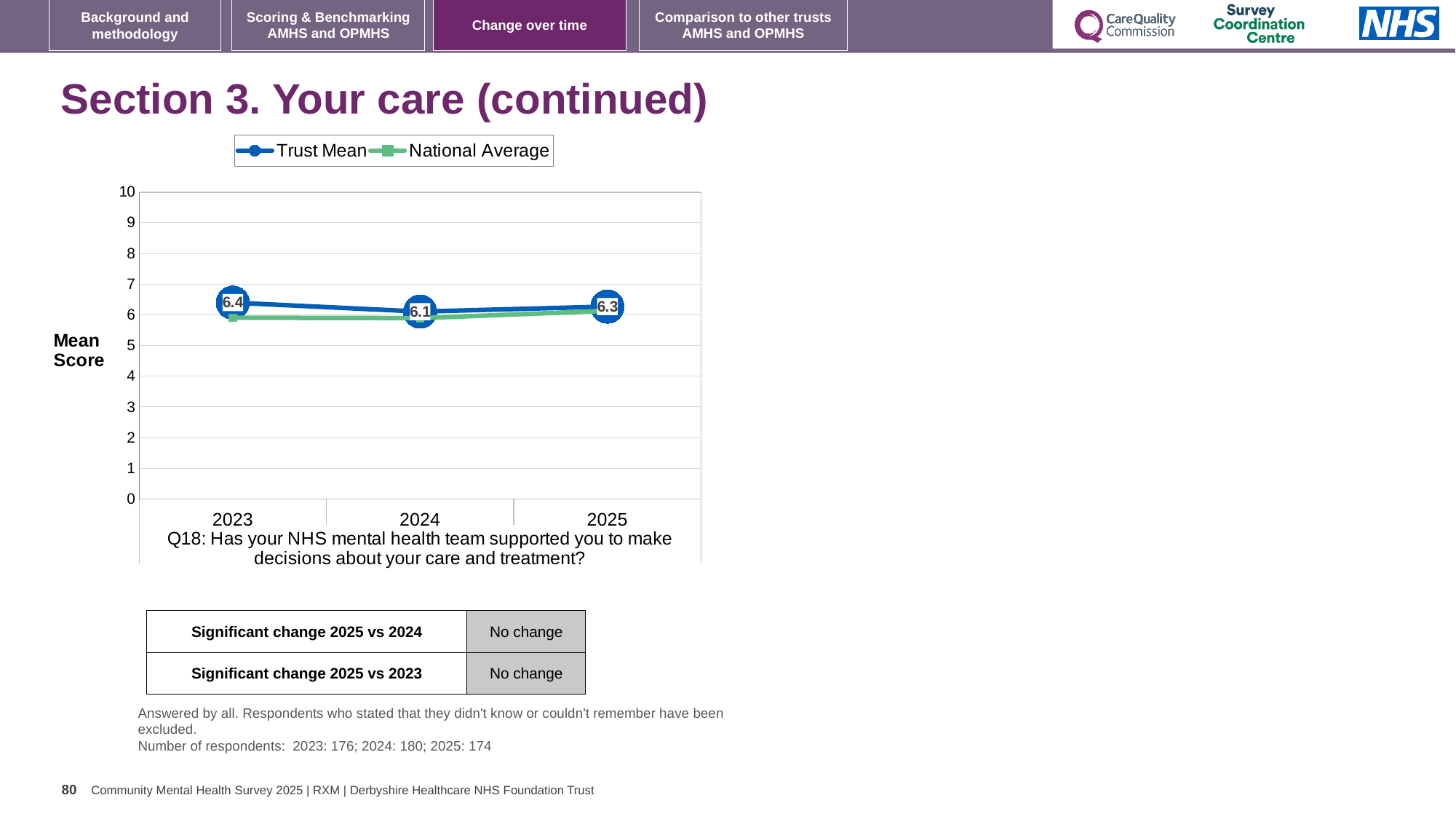
In which year is the Trust Mean lowest? 2024 What is the difference between the Trust Mean in 2023 and in 2024? 0.3 What is the Trust Mean score for 2024? 6.1 What kind of chart is shown on the slide? line chart How many series does the legend list? 2 In which year is the Trust Mean highest? 2023 What is the Trust Mean score for 2023? 6.4 How many years are shown on the x axis? 3 Is the National Average for 2023 greater or less than 7? less What is the Trust Mean score for 2025? 6.3 What is the label of the y axis? Mean Score Is the Trust Mean higher in 2025 or in 2024? 2025